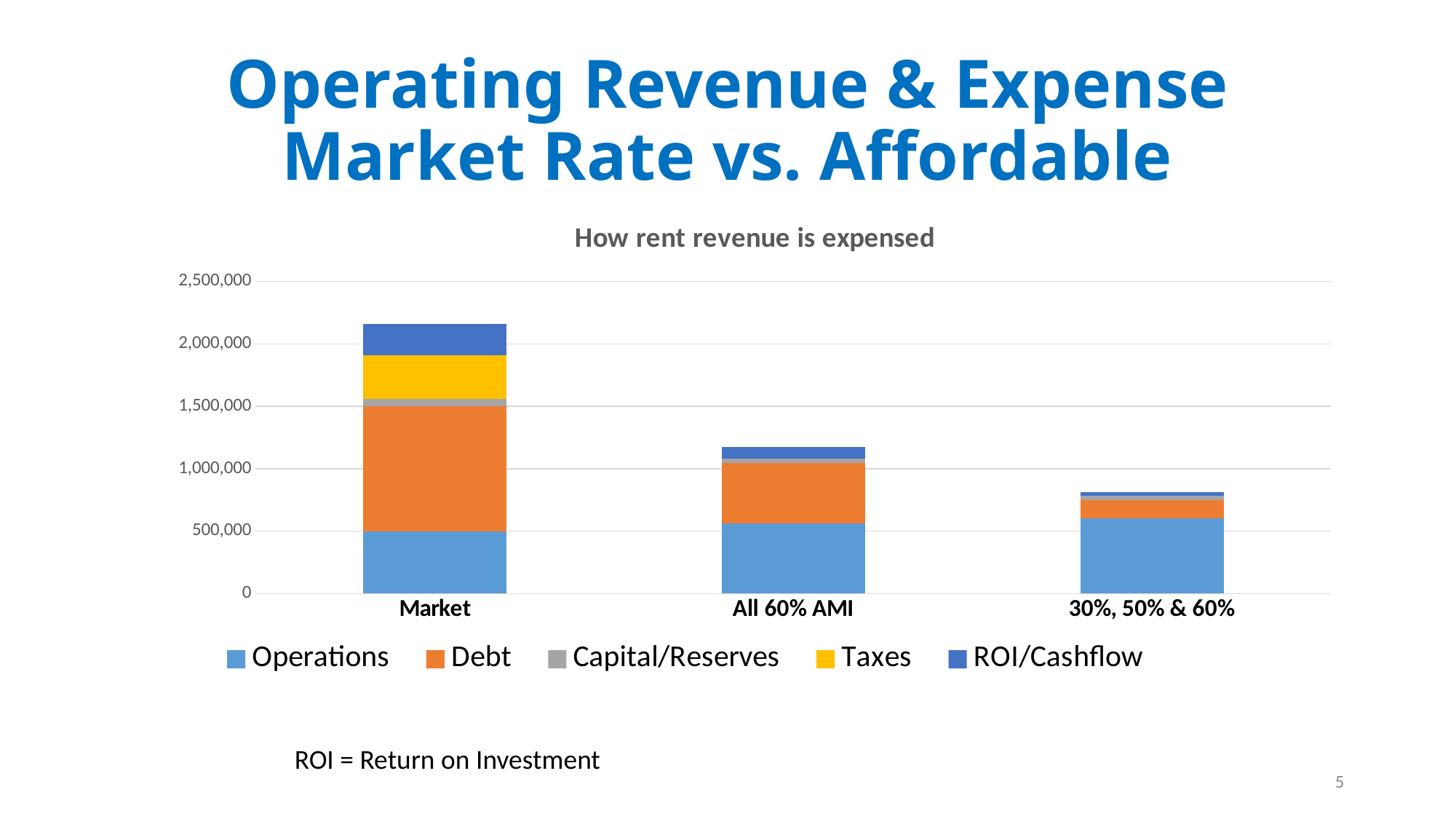
Is the total of the All 60% AMI bar greater or less than 1,000,000? greater Is the total of the Market bar greater or less than 2,000,000? greater Do the stacked bar totals rise or fall from left to right across the x axis? fall What is the title of the chart? How rent revenue is expensed How many categories are shown on the x axis? 3 Is the total of the 30%, 50% & 60% bar greater or less than 1,000,000? less Which series is shown in yellow in the legend? Taxes Which category has the tallest stacked bar? Market What kind of chart is shown on the slide? stacked bar chart How many series does the legend list? 5 Which category has the shortest stacked bar? 30%, 50% & 60% Which bar is taller, All 60% AMI or 30%, 50% & 60%? All 60% AMI